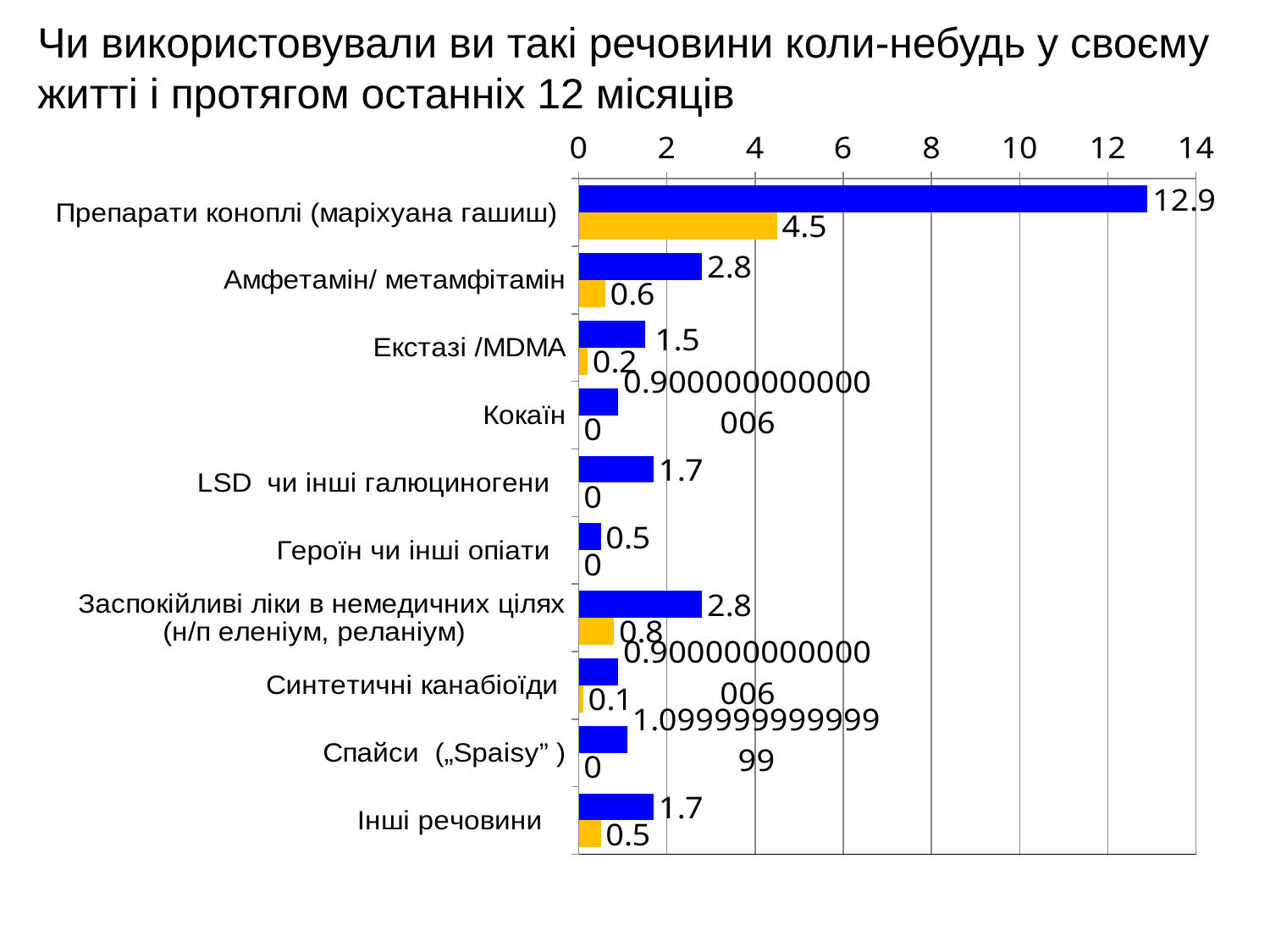
How many categories are shown on the chart? 10 Which category has the highest blue-bar value? Препарати коноплі (маріхуана гашиш) What kind of chart is shown on the slide? Bar chart What is the difference between the blue and orange bar values for Препарати коноплі (маріхуана гашиш)? 8.4 What is the value of the blue bar for LSD чи інші галюциногени? 1.7 Which has the larger blue-bar value, Амфетамін/ метамфітамін or Екстазі /MDMA? Амфетамін/ метамфітамін What is the difference between the blue and orange bar values for Заспокійливі ліки в немедичних цілях (н/п еленіум, реланіум)? 2.0 What is the value of the orange bar for Препарати коноплі (маріхуана гашиш)? 4.5 Is the blue-bar value for Препарати коноплі (маріхуана гашиш) greater or less than 12? greater Which category has the lowest blue-bar value? Героїн чи інші опіати What is the value of the blue bar for Препарати коноплі (маріхуана гашиш)? 12.9 What is the value of the orange bar for Амфетамін/ метамфітамін? 0.6